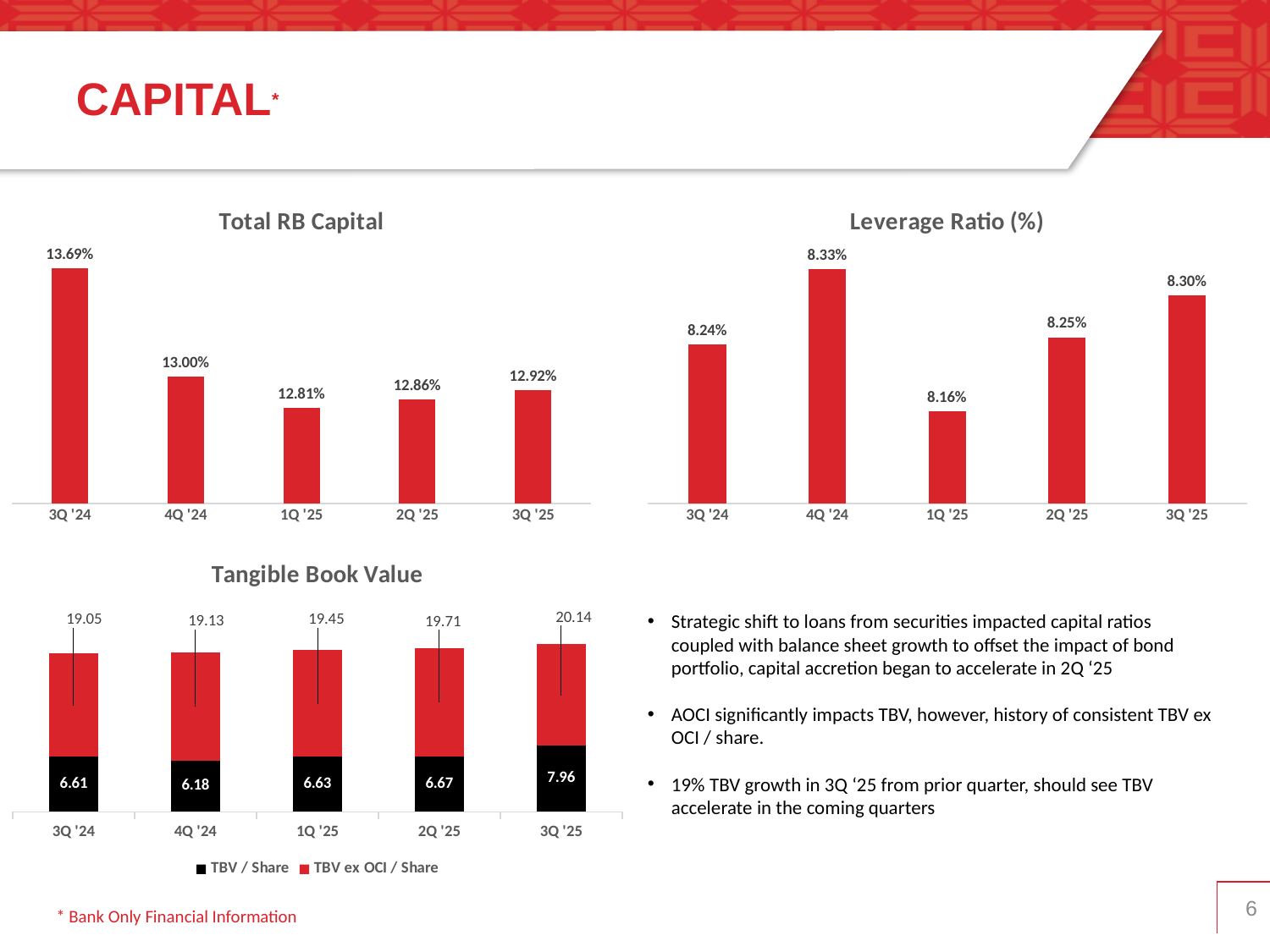
In the Leverage Ratio (%) chart, what is the value for 4Q '24? 8.33% In the Total RB Capital chart, what is the value for 3Q '24? 13.69% In the Total RB Capital chart, how many quarters are shown? 5 In the Tangible Book Value chart, what is the TBV / Share value for 3Q '25? 7.96 In the Tangible Book Value chart, how many series does the legend list? 2 In the Leverage Ratio (%) chart, which quarter has the lowest value? 1Q '25 In the Total RB Capital chart, which quarter has the lowest value? 1Q '25 What kind of chart is the Leverage Ratio (%) chart? Bar chart In the Tangible Book Value chart, which quarter has the lowest TBV / Share value? 4Q '24 In the Total RB Capital chart, what is the difference between 3Q '24 and 3Q '25? 0.77% In the Leverage Ratio (%) chart, which is larger, 2Q '25 or 3Q '25? 3Q '25 In the Leverage Ratio (%) chart, what is the difference between 4Q '24 and 1Q '25? 0.17%